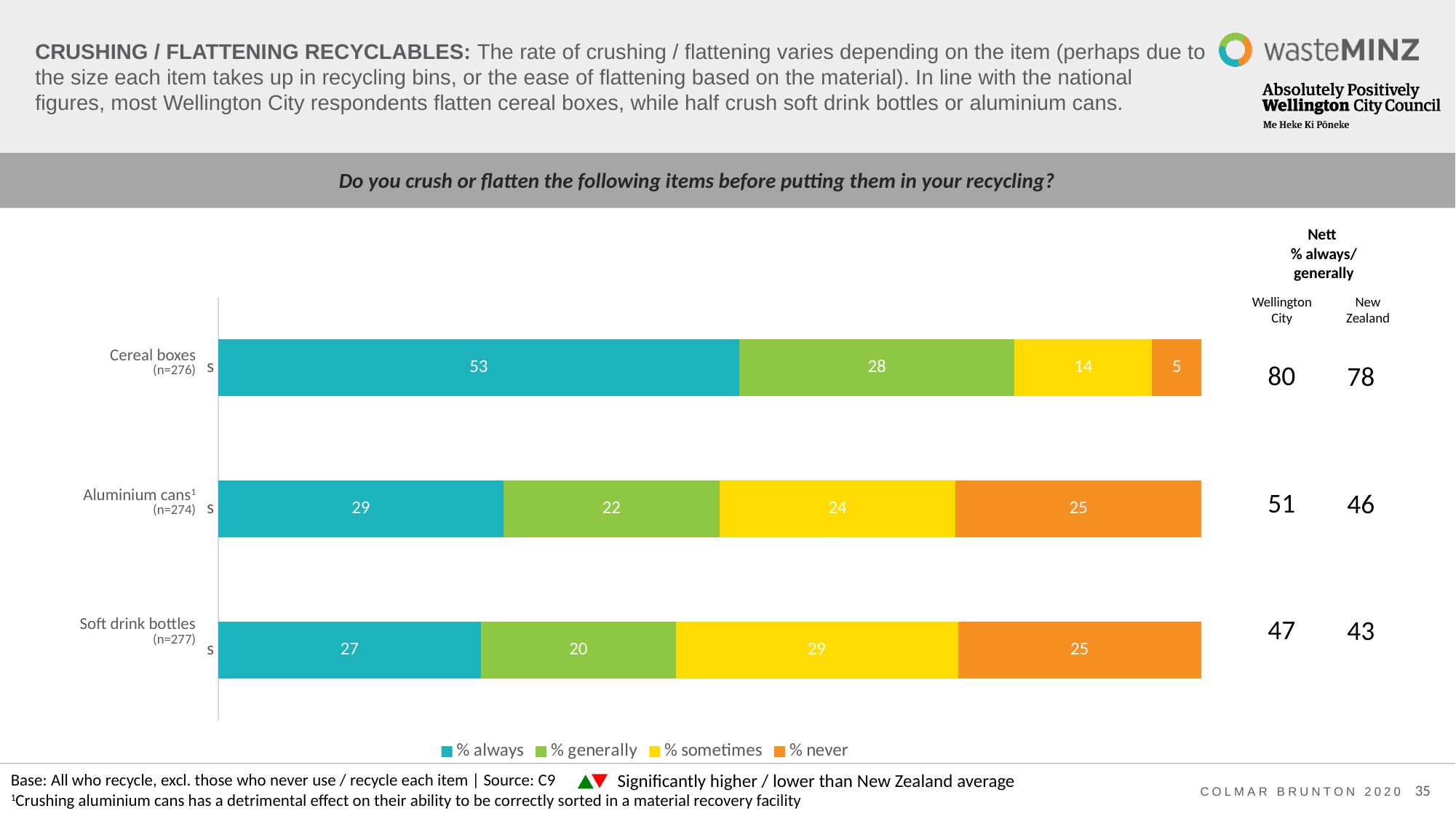
Which item has the lowest '% never' value? Cereal boxes What kind of chart is shown on the slide? Stacked bar chart What is the '% never' value for aluminium cans? 25 What is the total of the stacked bar for aluminium cans? 100 How many series does the legend list? 4 What is the Nett % always/generally value for Wellington City for soft drink bottles? 47 What is the difference between the '% always' values for cereal boxes and soft drink bottles? 26 How many items are shown in the chart? 3 Is the '% generally' value larger for aluminium cans or for soft drink bottles? Aluminium cans What is the '% sometimes' value for soft drink bottles? 29 What percentage of respondents say they always crush or flatten cereal boxes? 53 Which item has the highest '% always' value? Cereal boxes